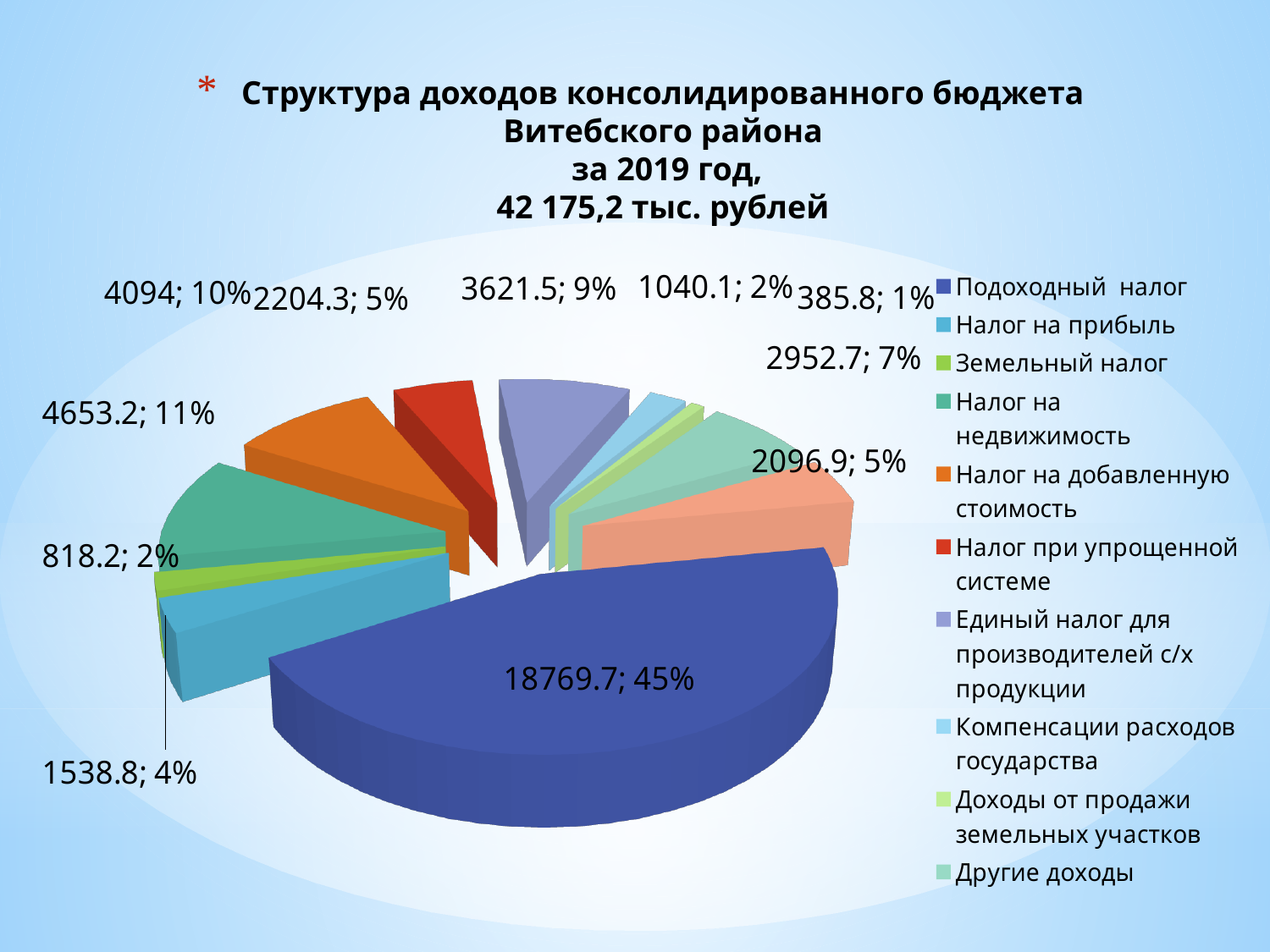
Which is larger, Налог на прибыль or Земельный налог? Налог на прибыль What total amount is stated in the chart title for 2019? 42 175,2 тыс. рублей What is the difference between the values for Налог на недвижимость and Налог на добавленную стоимость? 559.2 What value is shown for Налог на добавленную стоимость? 4094 How many entries does the legend list? 10 What value is shown for Единый налог для производителей с/х продукции? 3621.5 Which category has the smallest slice of the pie? Доходы от продажи земельных участков Which category has the largest slice of the pie? Подоходный налог What share of the pie does Налог на недвижимость represent? 11% What type of chart is shown on the slide? pie chart What value and share are shown for Подоходный налог? 18769.7; 45% What share of the pie does Доходы от продажи земельных участков represent? 1%